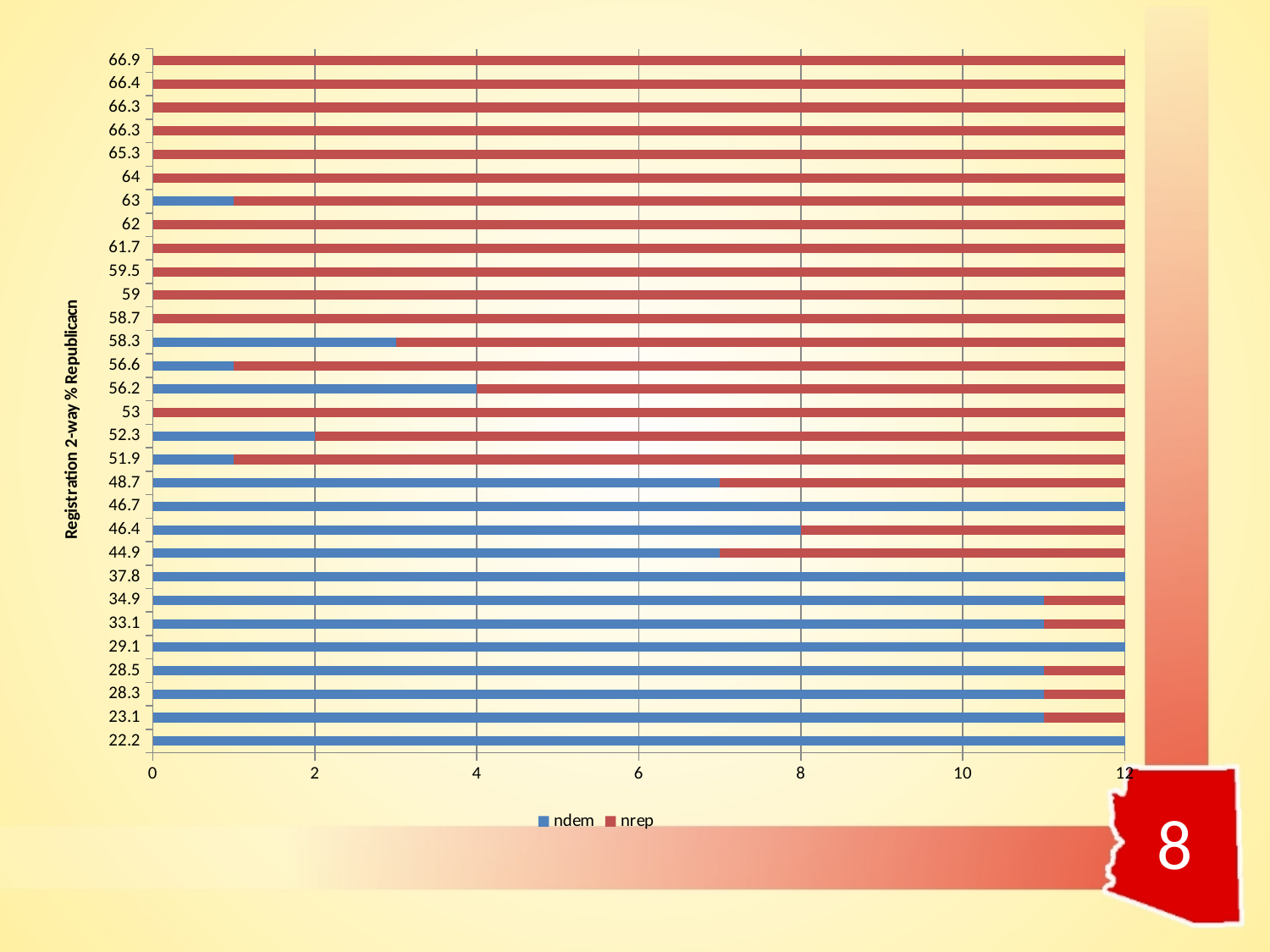
How many categories are plotted on the vertical axis? 30 What is the ndem value for the category labelled 56.2? 4 What are the two series named in the legend? ndem and nrep What kind of chart is shown on the slide? bar chart What is the nrep value for the category labelled 66.9? 12 Is the ndem value for the category labelled 48.7 greater or less than 6? greater What is the ndem value for the category labelled 52.3? 2 What is the ndem value for the category labelled 46.4? 8 Is the ndem value for the category labelled 63 greater or less than 2? less What is the total of the stacked bar for the category labelled 46.4? 12 Which is larger for the category labelled 34.9, the ndem value or the nrep value? ndem How many series does the legend list? 2